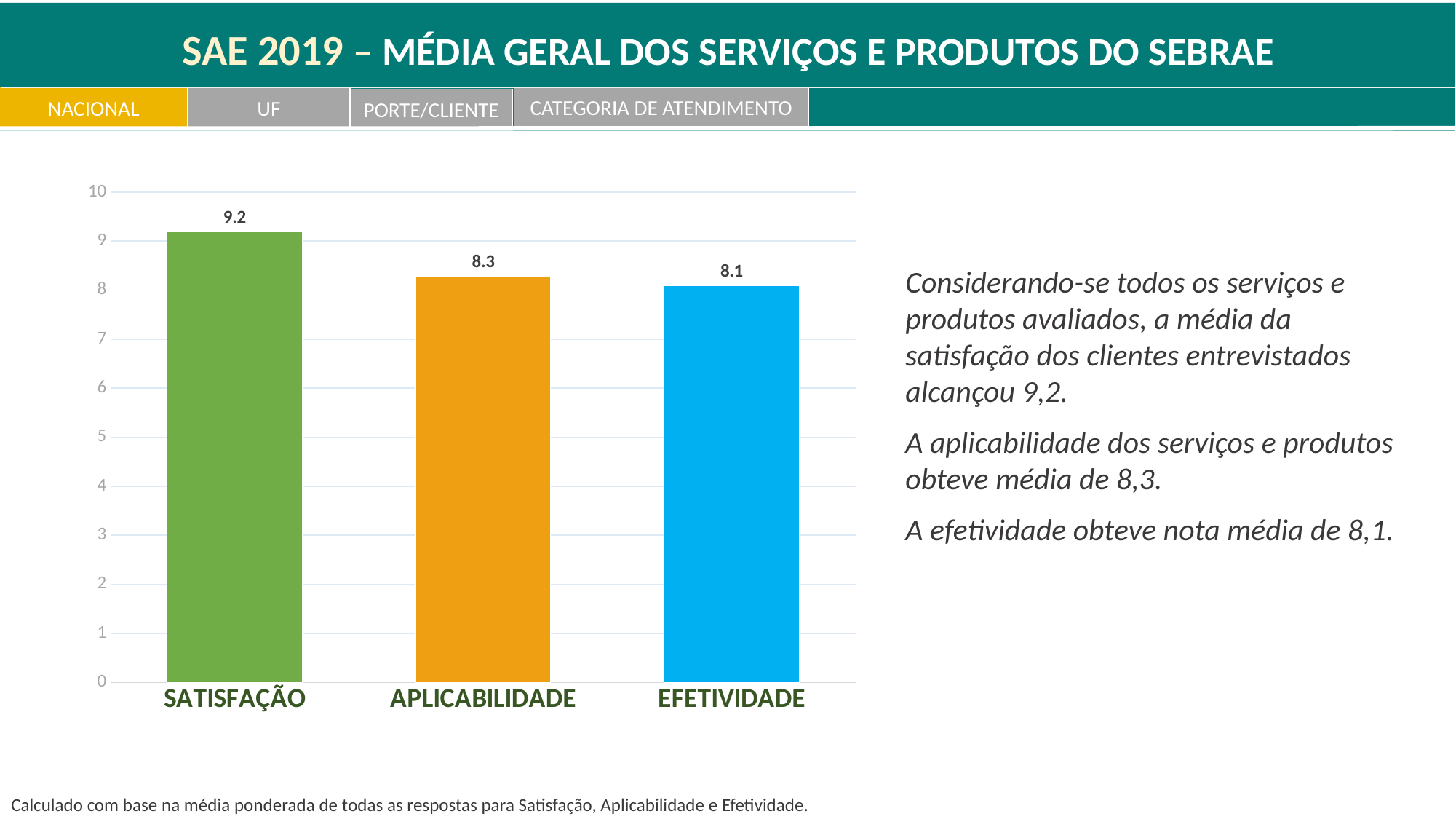
What kind of chart is shown on the slide? bar chart What is the value for APLICABILIDADE? 8.3 What is the difference between the values for SATISFAÇÃO and EFETIVIDADE? 1.1 What is the value for SATISFAÇÃO? 9.2 What is the value for EFETIVIDADE? 8.1 What is the difference between the values for SATISFAÇÃO and APLICABILIDADE? 0.9 Which category has the lowest value? EFETIVIDADE How many categories are shown in the chart? 3 Which category has the highest value? SATISFAÇÃO What colour is the bar for EFETIVIDADE? blue Is the value for SATISFAÇÃO greater or less than 9? greater Which is larger, the value for APLICABILIDADE or the value for EFETIVIDADE? APLICABILIDADE